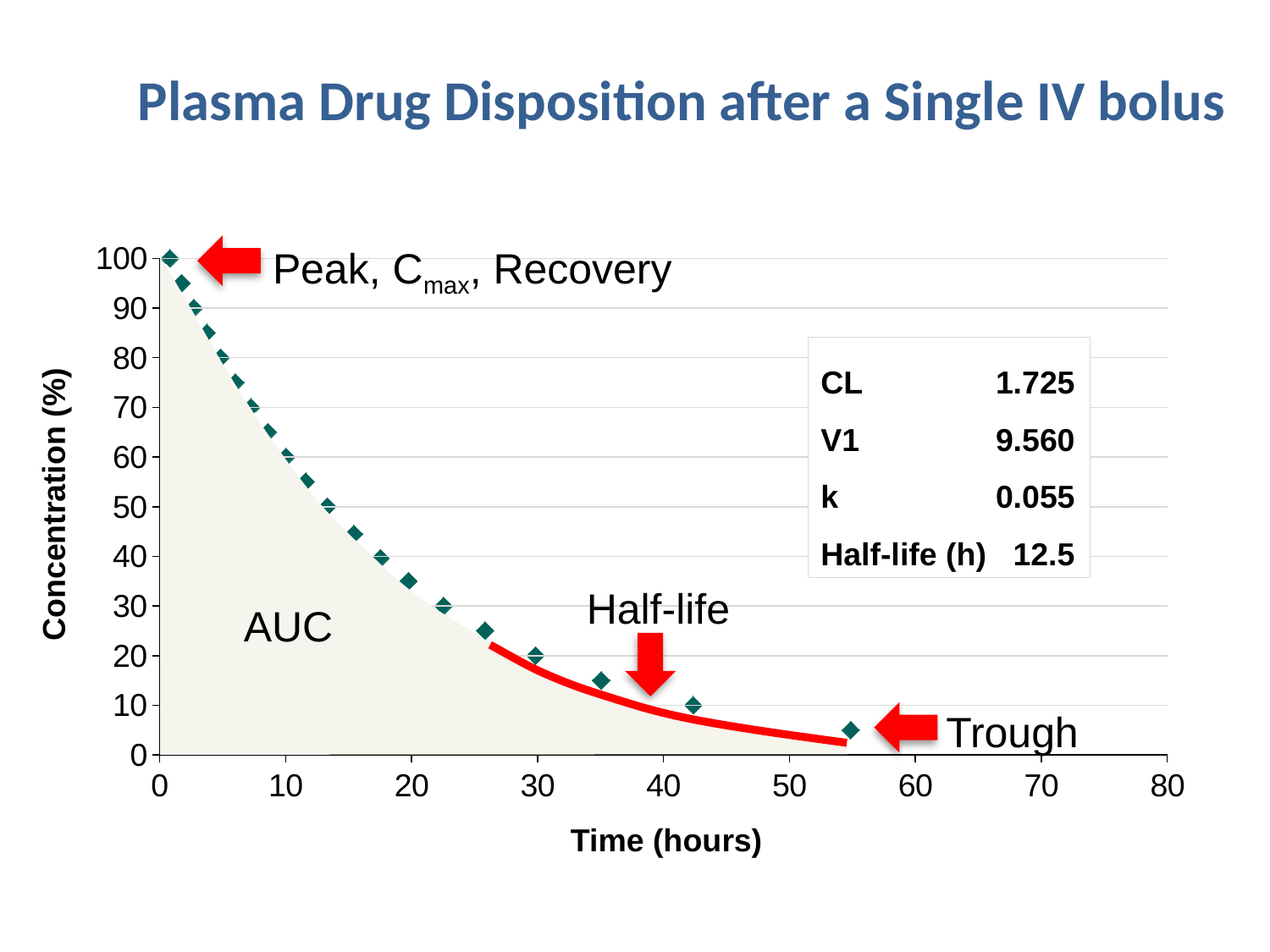
Is the concentration at about 20 hours greater or less than 30? greater Which is larger, the concentration at about 10 hours or at about 40 hours? at about 10 hours Is the concentration at about 30 hours greater or less than 30? less What is the title of the chart? Plasma Drug Disposition after a Single IV bolus What value is given for the half-life (h) in the box on the chart? 12.5 Is the concentration at about 10 hours greater or less than 50? greater What value is given for CL in the box on the chart? 1.725 What is the concentration (%) of the first plotted point, at the start of the time axis? 100 What is the label of the x axis? Time (hours) Do the plotted concentration values rise or fall as time increases? fall What value is given for k in the box on the chart? 0.055